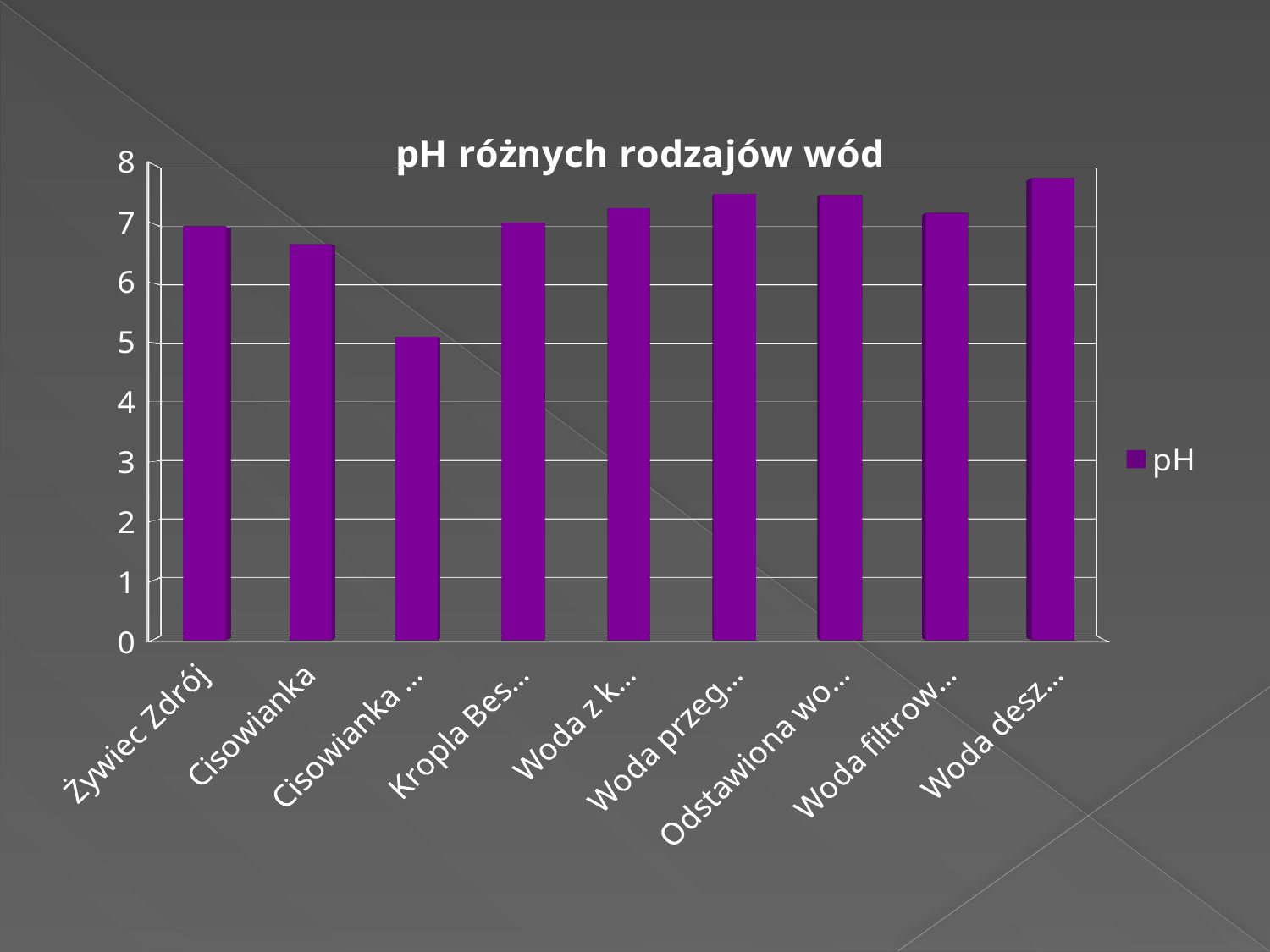
What kind of chart is shown on the slide? bar chart Is the value for the third bar from the left greater or less than 6? less Which has the higher pH value, Żywiec Zdrój or Cisowianka? Żywiec Zdrój Is the value for the last bar on the right (Woda desz...) greater or less than 7? greater Which bar position has the highest pH value in the chart? the last bar on the right How many series does the legend list? 1 How many categories (bars) are plotted in the chart? 9 Is the value for Cisowianka greater or less than 7? less What series name is shown in the legend? pH What is the title of the chart? pH różnych rodzajów wód Which bar position has the lowest pH value in the chart? the third bar from the left